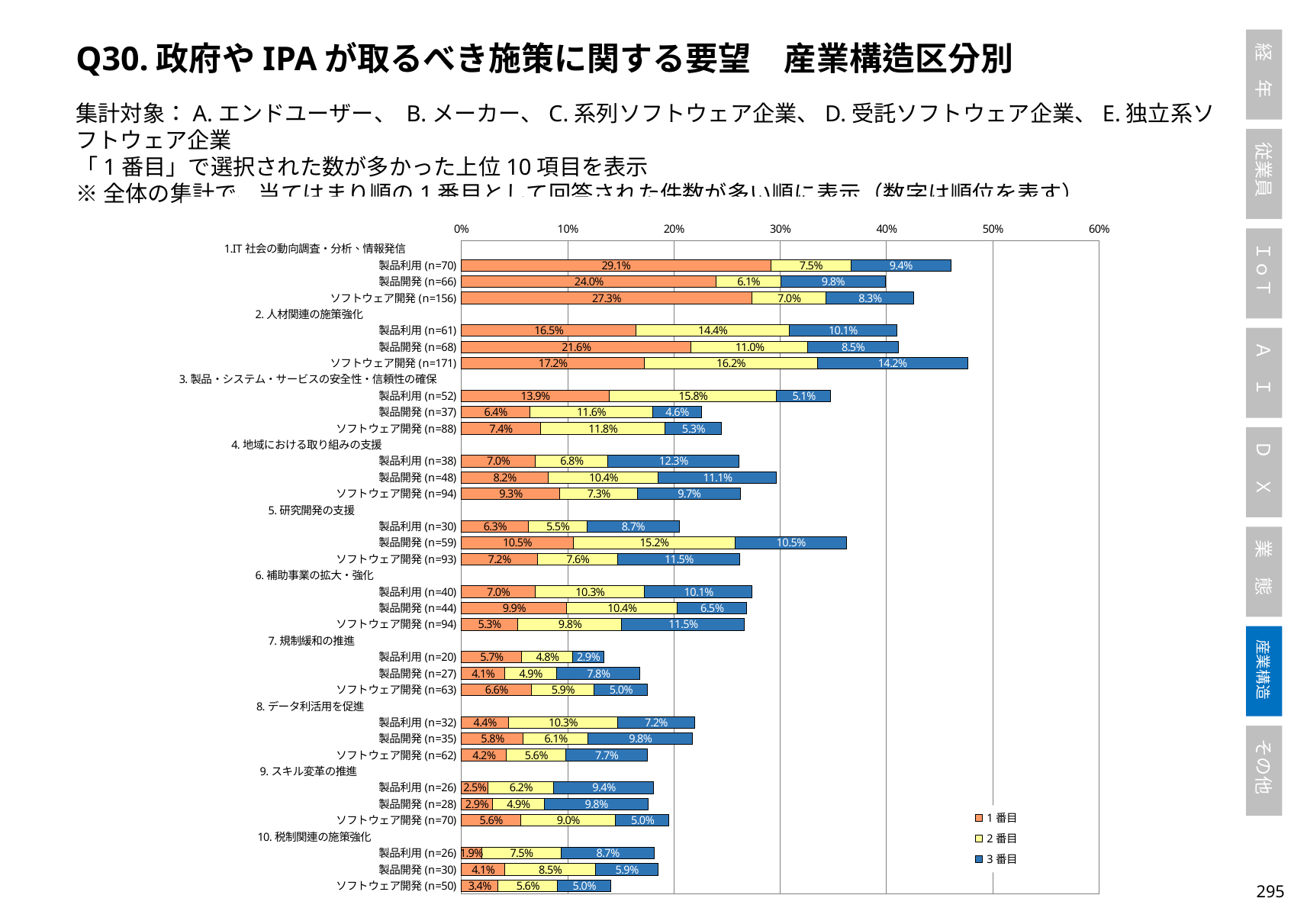
Is the total of the stacked bar for ソフトウェア開発 (n=50) under 10. 税制関連の施策強化 greater or less than 20%? less What are the three legend entries of the chart? 1番目, 2番目, 3番目 How many series does the legend list? 3 What is the 3番目 value for ソフトウェア開発 (n=171) under 2. 人材関連の施策強化? 14.2% What is the 1番目 value for 製品利用 (n=70) under 1.IT社会の動向調査・分析、情報発信? 29.1% What kind of chart is shown on the slide? Stacked bar chart Under 1.IT社会の動向調査・分析、情報発信, which has the larger 1番目 value: 製品利用 (n=70) or 製品開発 (n=66)? 製品利用 (n=70) What is the total of the stacked bar for 製品利用 (n=70) under 1.IT社会の動向調査・分析、情報発信? 46.0% Under 5. 研究開発の支援, what is the difference between the 2番目 values for 製品開発 (n=59) and 製品利用 (n=30)? 9.7 percentage points What is the 2番目 value for 製品利用 (n=32) under 8. データ利活用を促進? 10.3% Which series has the largest segment in the bar for 製品開発 (n=68) under 2. 人材関連の施策強化? 1番目 What is the 1番目 value for 製品利用 (n=26) under 10. 税制関連の施策強化? 1.9%